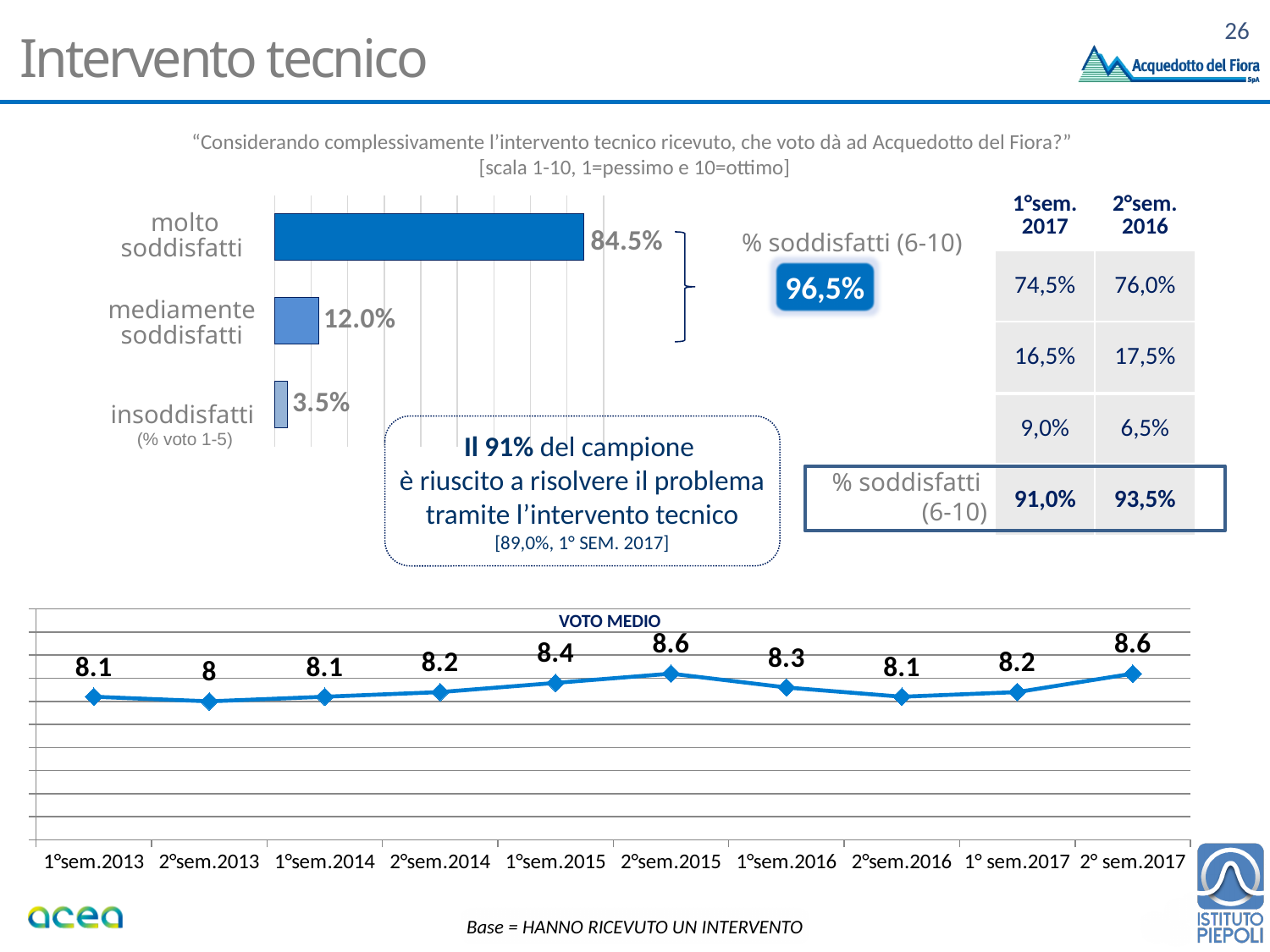
In the VOTO MEDIO chart, which is larger: the value for 1°sem.2015 or the value for 1°sem.2016? 1°sem.2015 In the bar chart, what is the value for "molto soddisfatti"? 84.5% In the VOTO MEDIO chart, which period has the lowest value? 2°sem.2013 In the VOTO MEDIO chart, what is the value for 2°sem.2015? 8.6 In the VOTO MEDIO chart, how many data points are plotted? 10 In the bar chart, how many categories are shown? 3 What kind of chart is the VOTO MEDIO chart? line chart In the bar chart, what is the difference between "molto soddisfatti" and "mediamente soddisfatti"? 72.5% In the VOTO MEDIO chart, what is the value for 2°sem.2013? 8 What kind of chart is the chart at the top left of the slide? bar chart In the bar chart, which category has the lowest value? insoddisfatti In the bar chart, what is the value for "insoddisfatti"? 3.5%